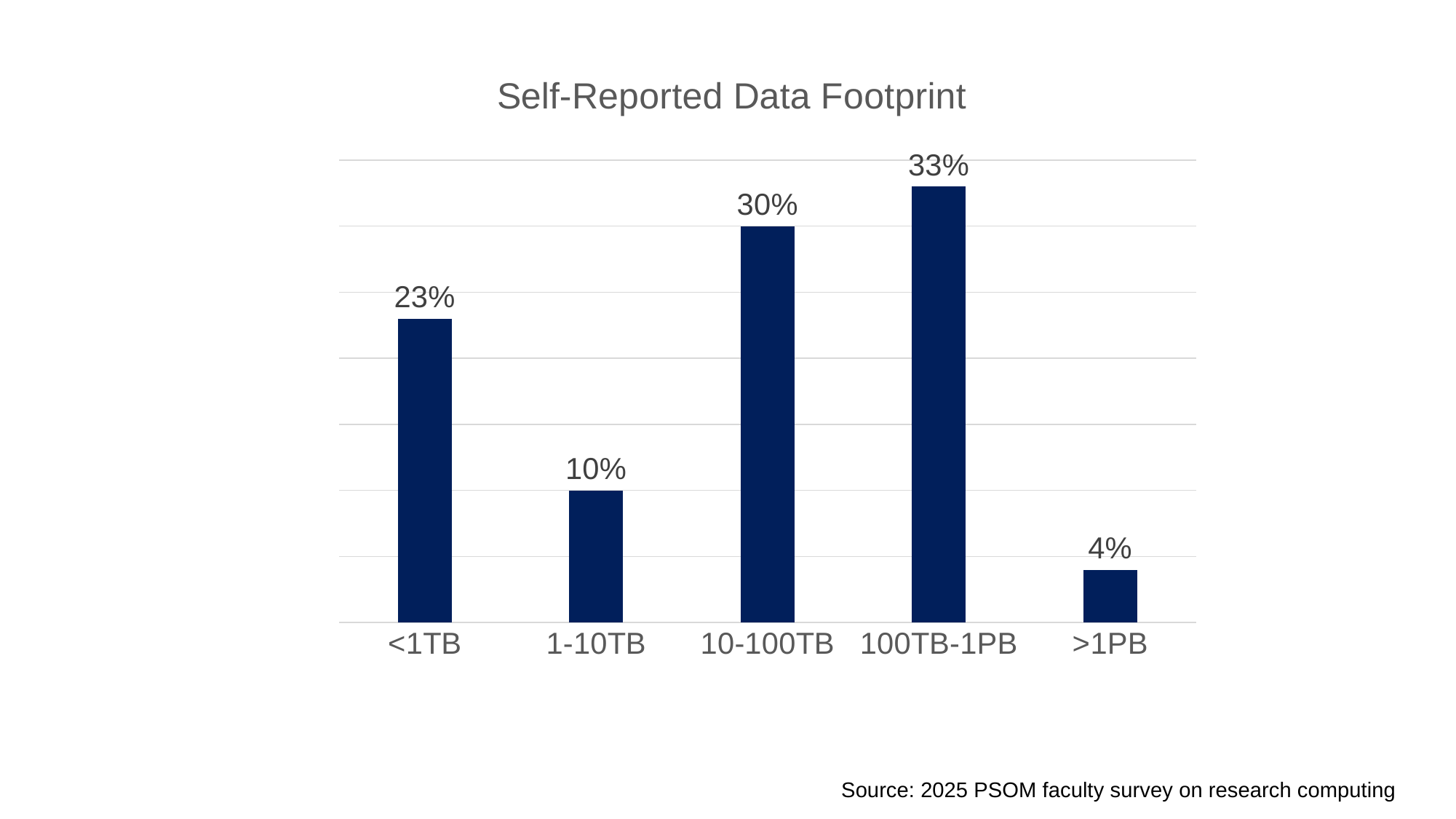
What is the title of the chart? Self-Reported Data Footprint Which category has the highest value? 100TB-1PB What is the value for <1TB? 23% Which is larger, the value for <1TB or the value for 1-10TB? <1TB Which category has the lowest value? >1PB What is the value for 10-100TB? 30% What is the value for 1-10TB? 10% What kind of chart is this? Bar chart How many categories are shown on the x axis? 5 What is the value for >1PB? 4% What is the difference between the values for 100TB-1PB and <1TB? 10% What is the value for 100TB-1PB? 33%